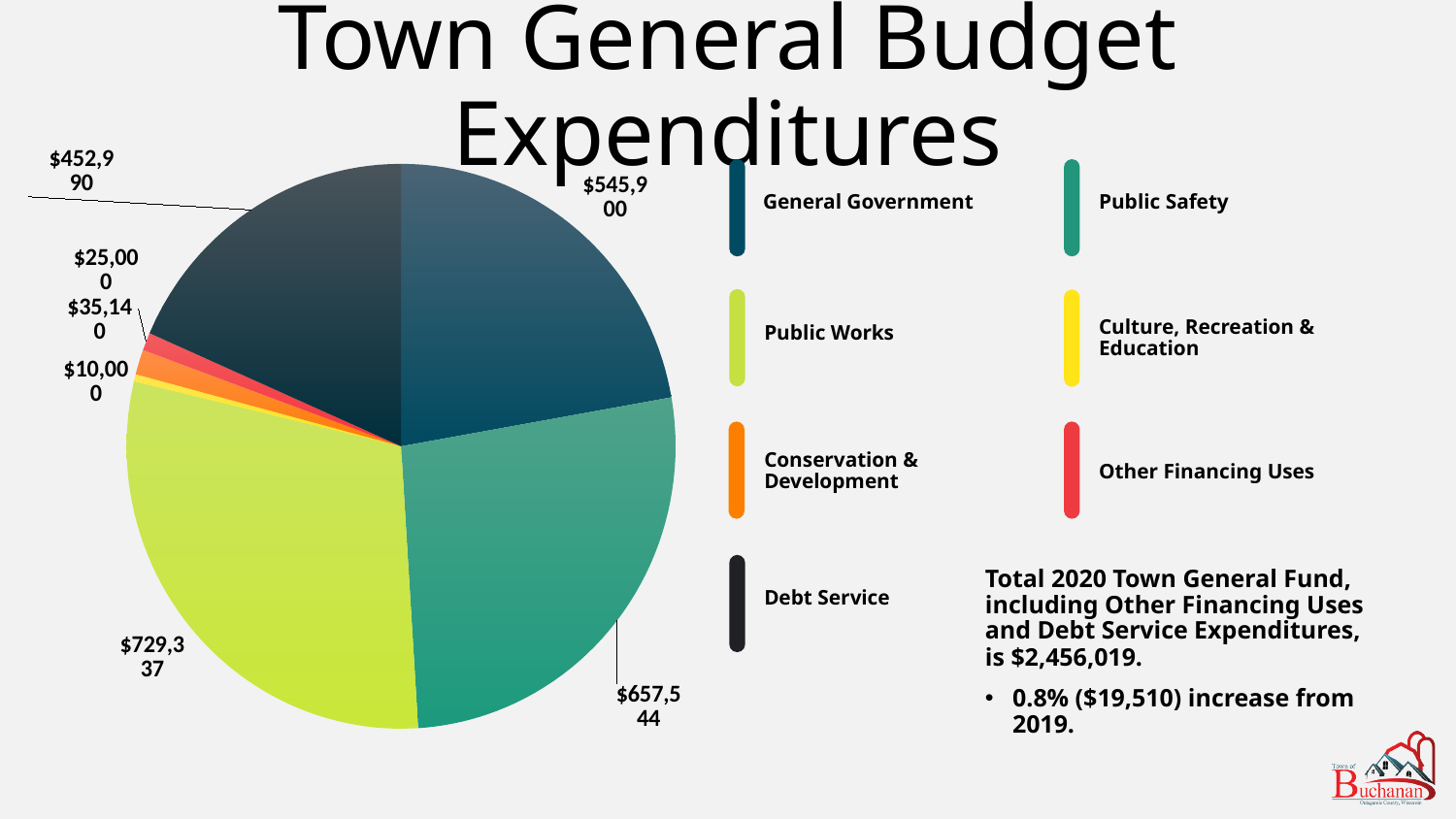
What is the value for Public Works? $729,337 What kind of chart is shown on the slide? pie chart Which category has the largest slice of the pie? Public Works Which is larger, Conservation & Development or Other Financing Uses? Conservation & Development What is the value for Public Safety? $657,544 What is the value for Culture, Recreation & Education? $10,000 What is the value for Debt Service? $452,990 What is the value for General Government? $545,900 What is the difference between the Public Works and Public Safety values? $71,793 How many categories does the pie chart have? 7 What is the title of the chart? Town General Budget Expenditures Which category has the smallest slice of the pie? Culture, Recreation & Education